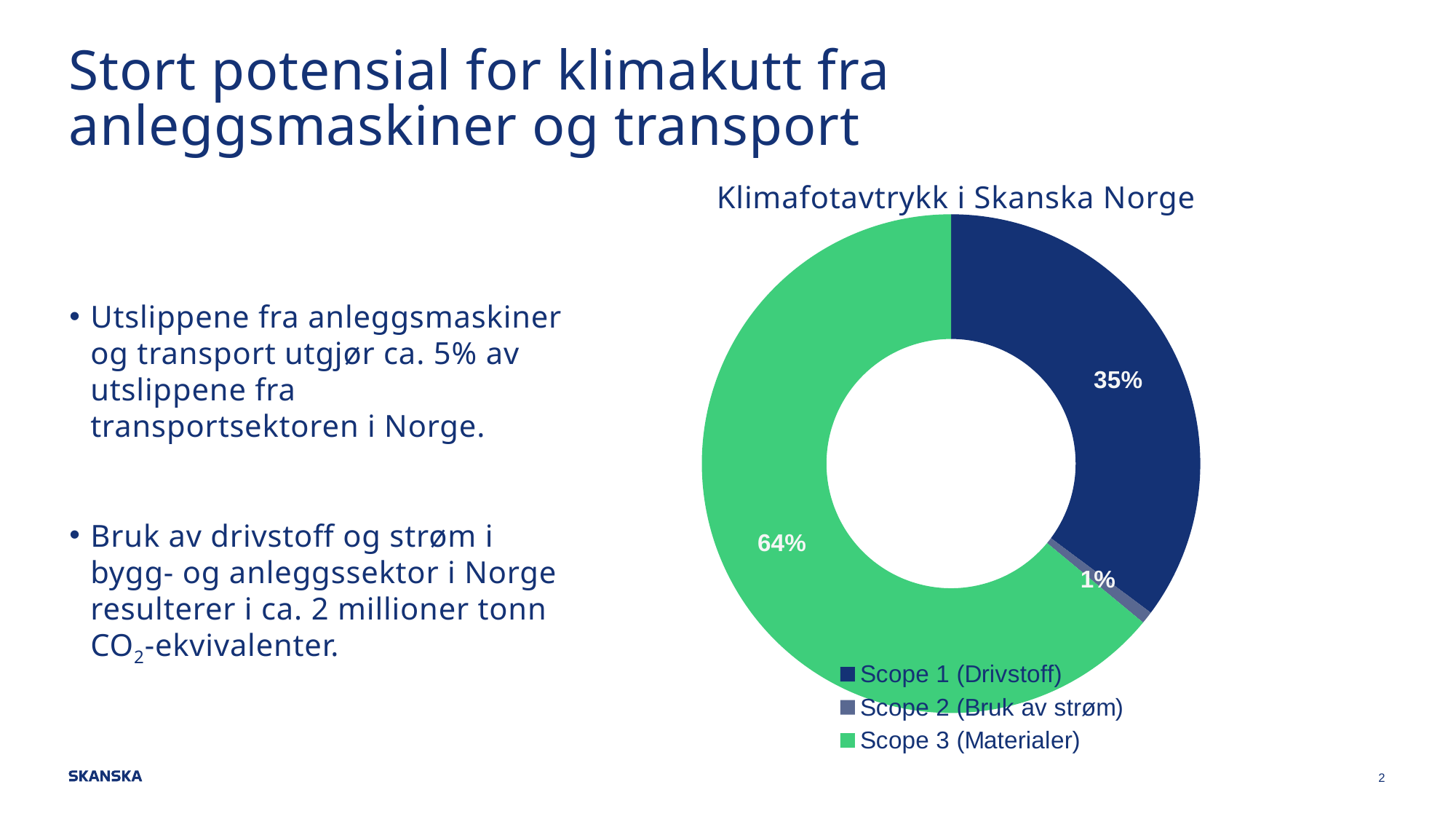
What share of the chart does Scope 3 (Materialer) account for? 64% What share of the chart does Scope 2 (Bruk av strøm) account for? 1% What is the title of the chart? Klimafotavtrykk i Skanska Norge What kind of chart is shown on the slide? Pie chart (doughnut) What is the difference in percentage points between Scope 3 (Materialer) and Scope 1 (Drivstoff)? 29 percentage points What colour is the Scope 3 (Materialer) slice? Green What is the combined share of Scope 1 (Drivstoff) and Scope 2 (Bruk av strøm)? 36% Which category has the largest share of the chart? Scope 3 (Materialer) Which is larger, the share for Scope 1 (Drivstoff) or the share for Scope 2 (Bruk av strøm)? Scope 1 (Drivstoff) What share of the chart does Scope 1 (Drivstoff) account for? 35% Which category has the smallest share of the chart? Scope 2 (Bruk av strøm) How many categories does the chart show? 3